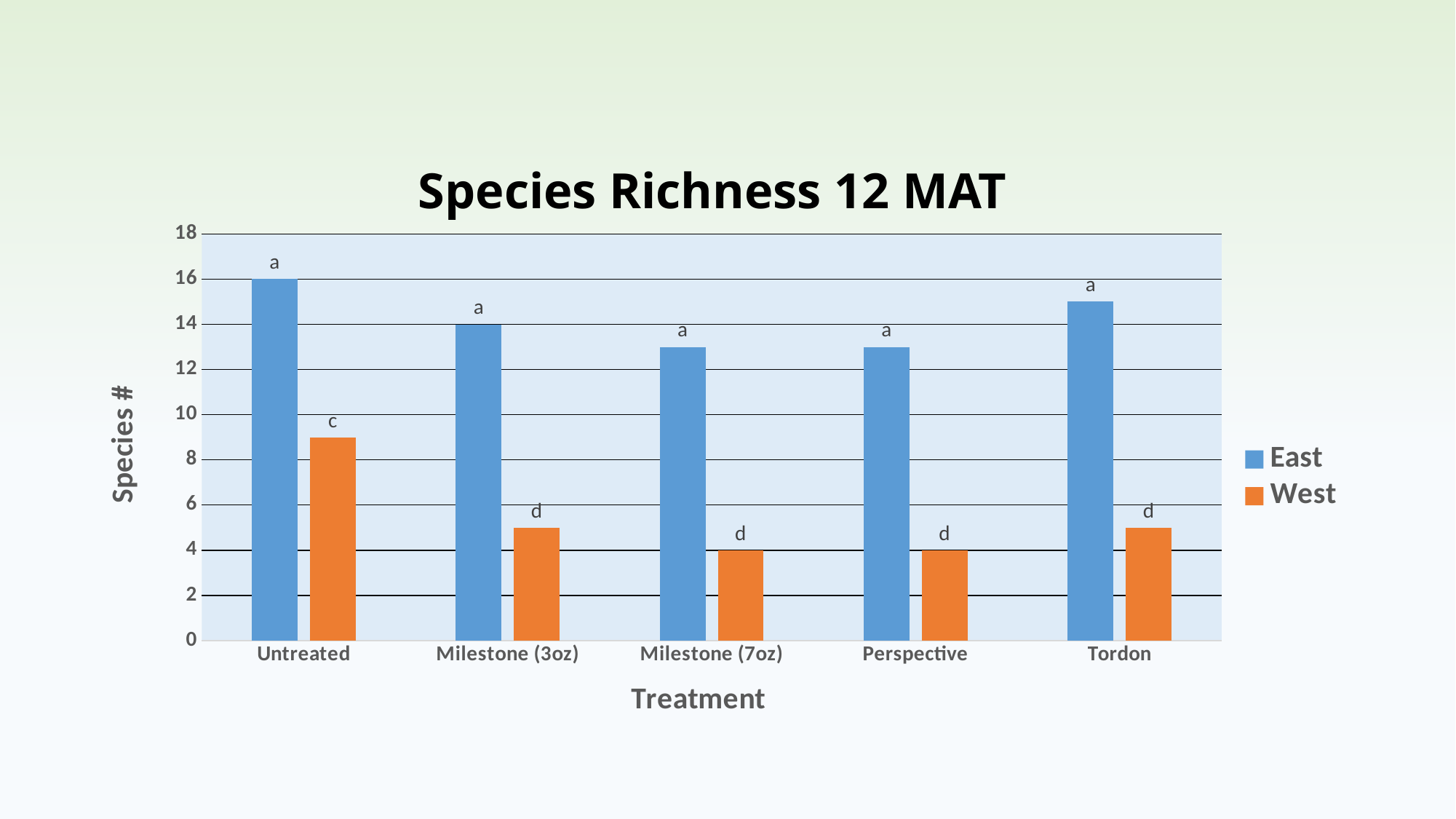
Which is larger in the Untreated category, the East value or the West value? East What is the value for East in the Untreated category? 16 What is the value for West in the Perspective category? 4 What type of chart is shown on the slide? Bar chart What is the value for East in the Milestone (3oz) category? 14 How many series does the legend list? 2 Is the East value for Tordon greater or less than 14? greater How many treatment categories are shown on the x axis? 5 What is the difference between the East values for Untreated and Milestone (3oz)? 2 Which treatment has the highest West value? Untreated Which treatment has the highest East value? Untreated Is the West value for Untreated greater or less than 8? greater